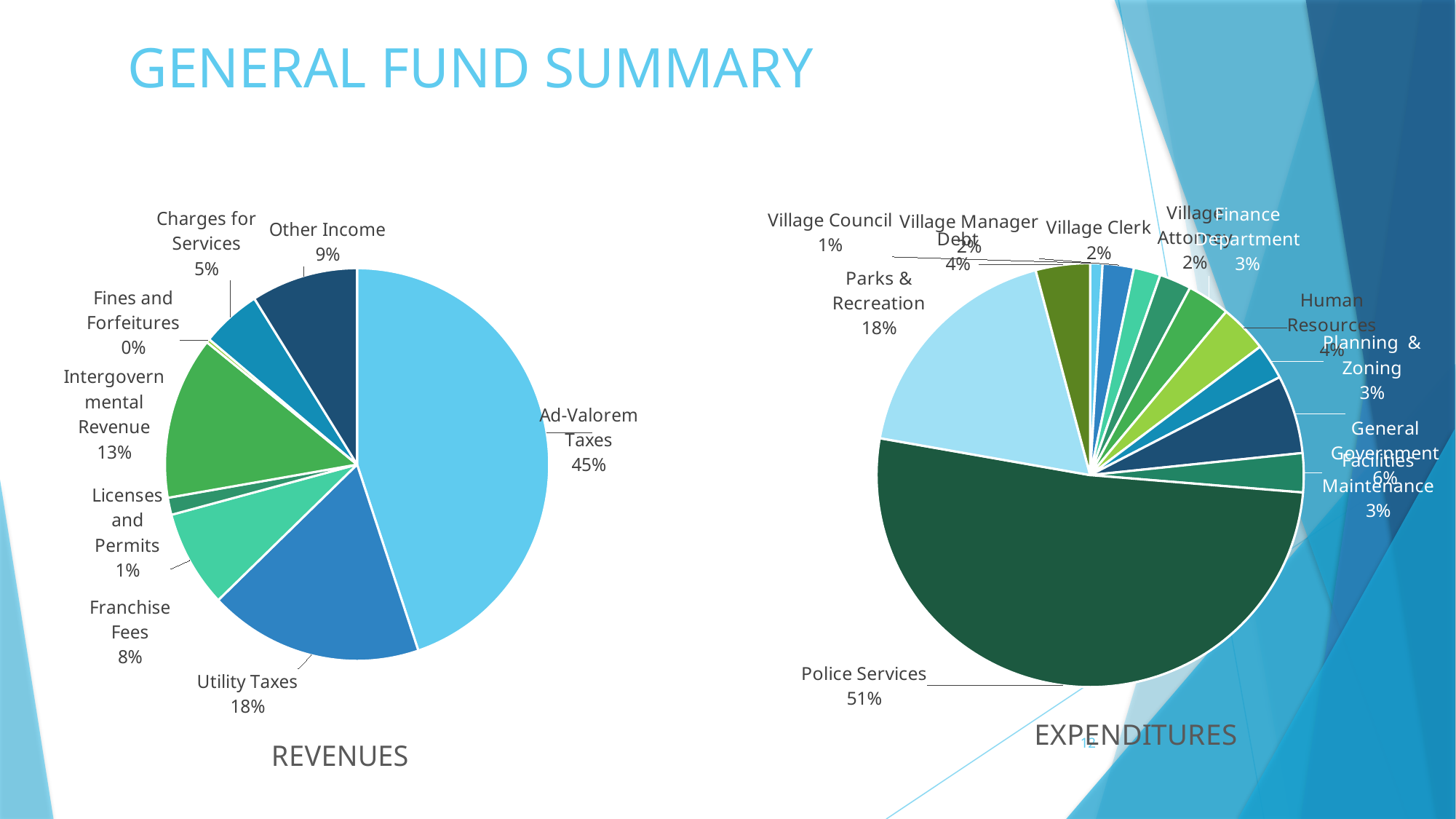
In the REVENUES pie chart, what is the difference between the shares of Intergovernmental Revenue and Franchise Fees? 5% In the EXPENDITURES pie chart, which category has the largest share? Police Services In the REVENUES pie chart, what share do Ad-Valorem Taxes represent? 45% In the REVENUES pie chart, what share do Utility Taxes represent? 18% In the REVENUES pie chart, which category has the largest share? Ad-Valorem Taxes What type of chart is used for the EXPENDITURES chart? Pie chart In the EXPENDITURES pie chart, what share does Parks & Recreation represent? 18% How many categories are shown in the REVENUES pie chart? 8 In the REVENUES pie chart, which category has the smallest share? Fines and Forfeitures In the EXPENDITURES pie chart, what share do Police Services represent? 51% In the REVENUES pie chart, which is larger: Other Income or Charges for Services? Other Income In the EXPENDITURES pie chart, what is the difference between the shares of Police Services and Parks & Recreation? 33%